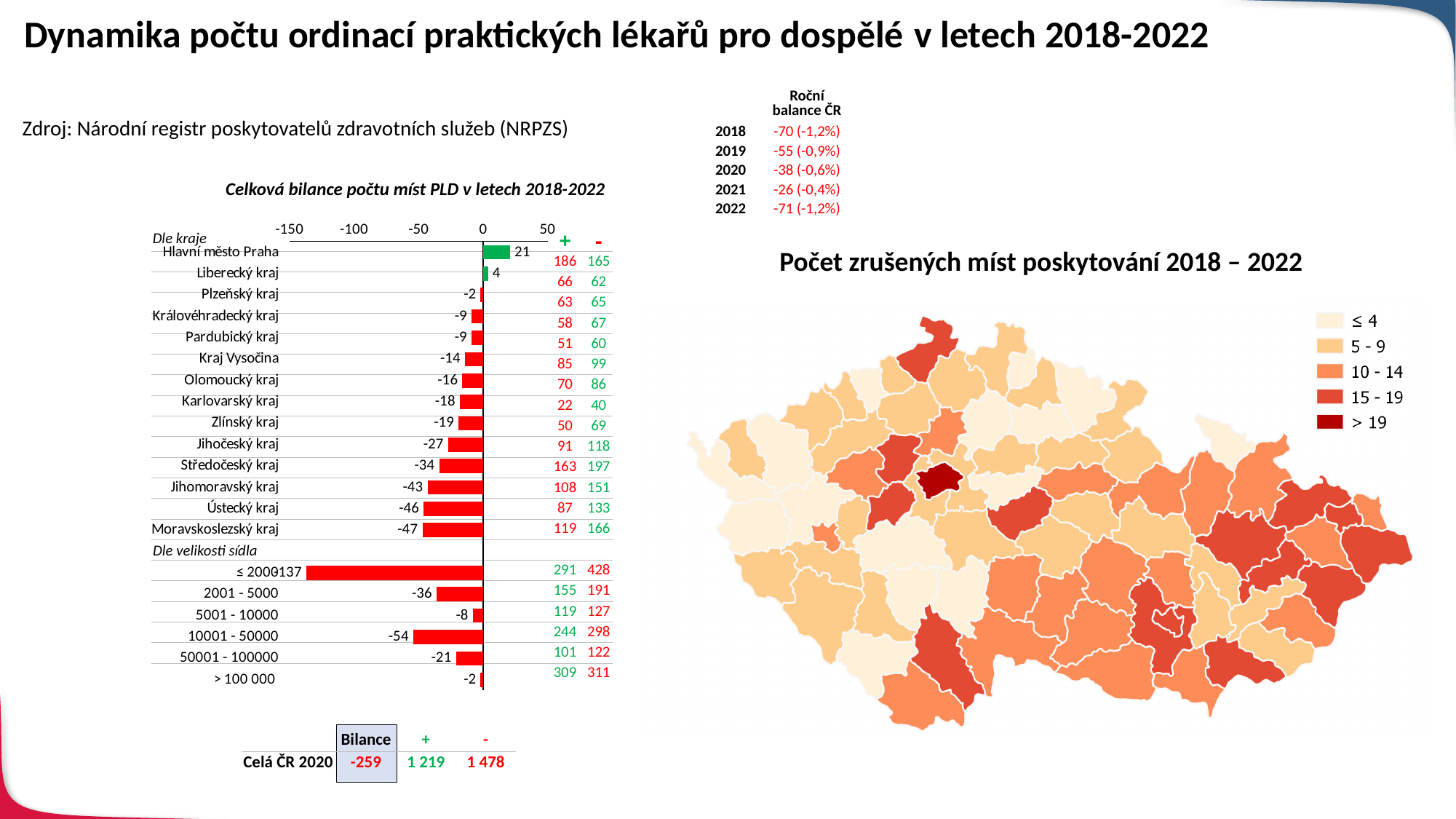
In the bar chart 'Celková bilance počtu míst PLD v letech 2018-2022', which region (kraj) has the highest value? Hlavní město Praha In the bar chart 'Celková bilance počtu míst PLD v letech 2018-2022', how many regions (kraje) are listed under 'Dle kraje'? 14 In the bar chart 'Celková bilance počtu míst PLD v letech 2018-2022', what is the value for Hlavní město Praha? 21 In the bar chart 'Celková bilance počtu míst PLD v letech 2018-2022', what is the difference between the values for Jihomoravský kraj and Ústecký kraj? 3 In the bar chart 'Celková bilance počtu míst PLD v letech 2018-2022', which settlement size category has the lowest value? ≤ 2000 In the bar chart 'Celková bilance počtu míst PLD v letech 2018-2022', which region (kraj) has the lowest value? Moravskoslezský kraj In the bar chart 'Celková bilance počtu míst PLD v letech 2018-2022', which has the larger value, Liberecký kraj or Plzeňský kraj? Liberecký kraj In the bar chart 'Celková bilance počtu míst PLD v letech 2018-2022', what is the value for Moravskoslezský kraj? -47 What kind of chart is 'Celková bilance počtu míst PLD v letech 2018-2022'? bar chart In the bar chart 'Celková bilance počtu míst PLD v letech 2018-2022', what is the value for the settlement size category ≤ 2000? -137 In the bar chart 'Celková bilance počtu míst PLD v letech 2018-2022', how many settlement size categories are listed under 'Dle velikosti sídla'? 6 How many value ranges does the legend of the map 'Počet zrušených míst poskytování 2018 – 2022' list? 5